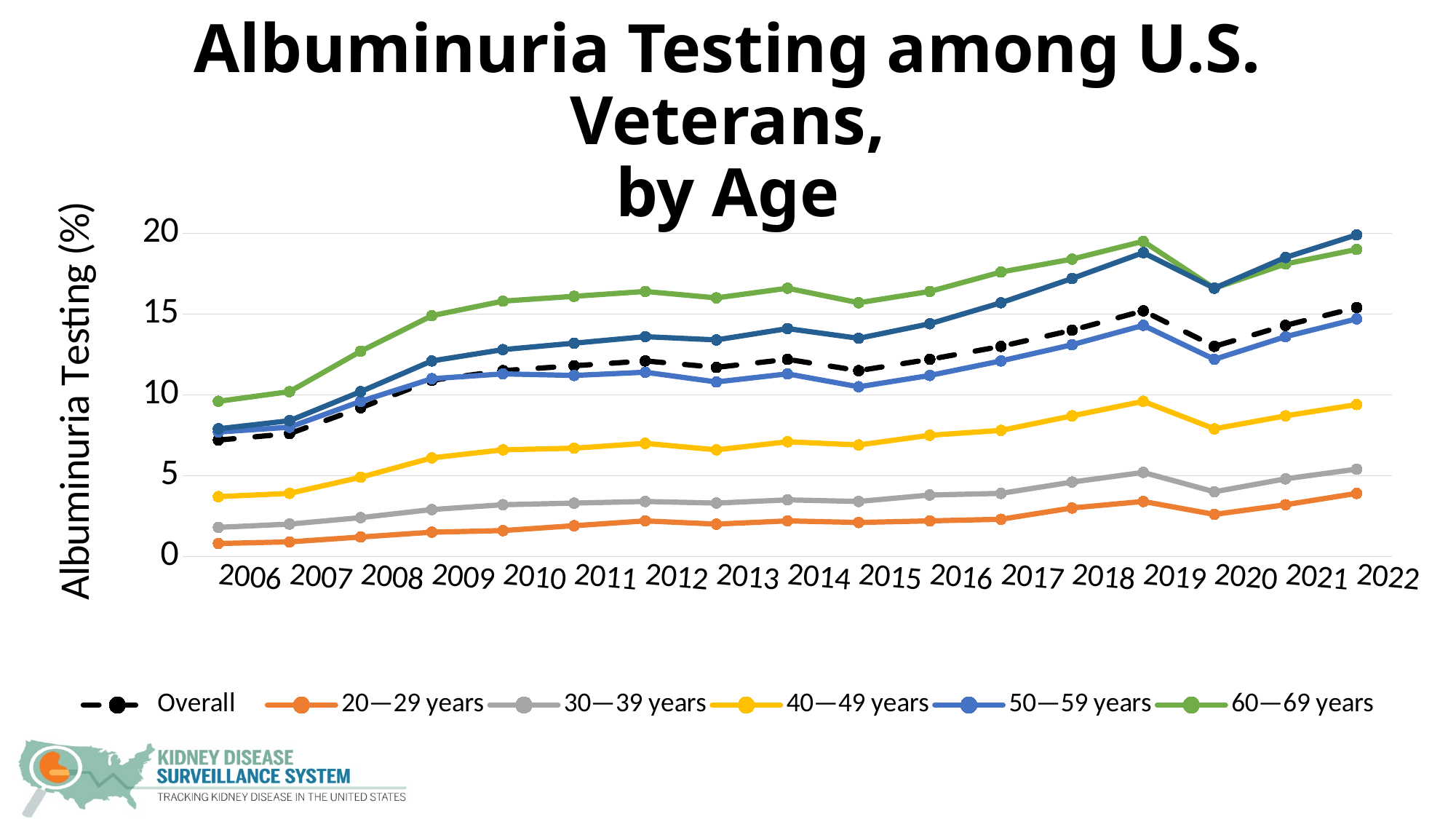
How many series does the legend list? 6 What is the label on the y axis? Albuminuria Testing (%) Which age group has the lowest albuminuria testing percentage in 2022? 20—29 years Is the value for 60—69 years in 2018 greater or less than 15? greater Does the albuminuria testing percentage for 20—29 years generally rise or fall from 2006 to 2022? rise How many years are shown along the x axis? 17 In 2022, which is larger: the value for 60—69 years or the value for 20—29 years? 60—69 years Is the value for 40—49 years in 2022 greater or less than 10? less What kind of chart is shown on the slide? line chart Is the value for 20—29 years in 2006 greater or less than 5? less Which age group has the highest albuminuria testing percentage in 2006? 60—69 years